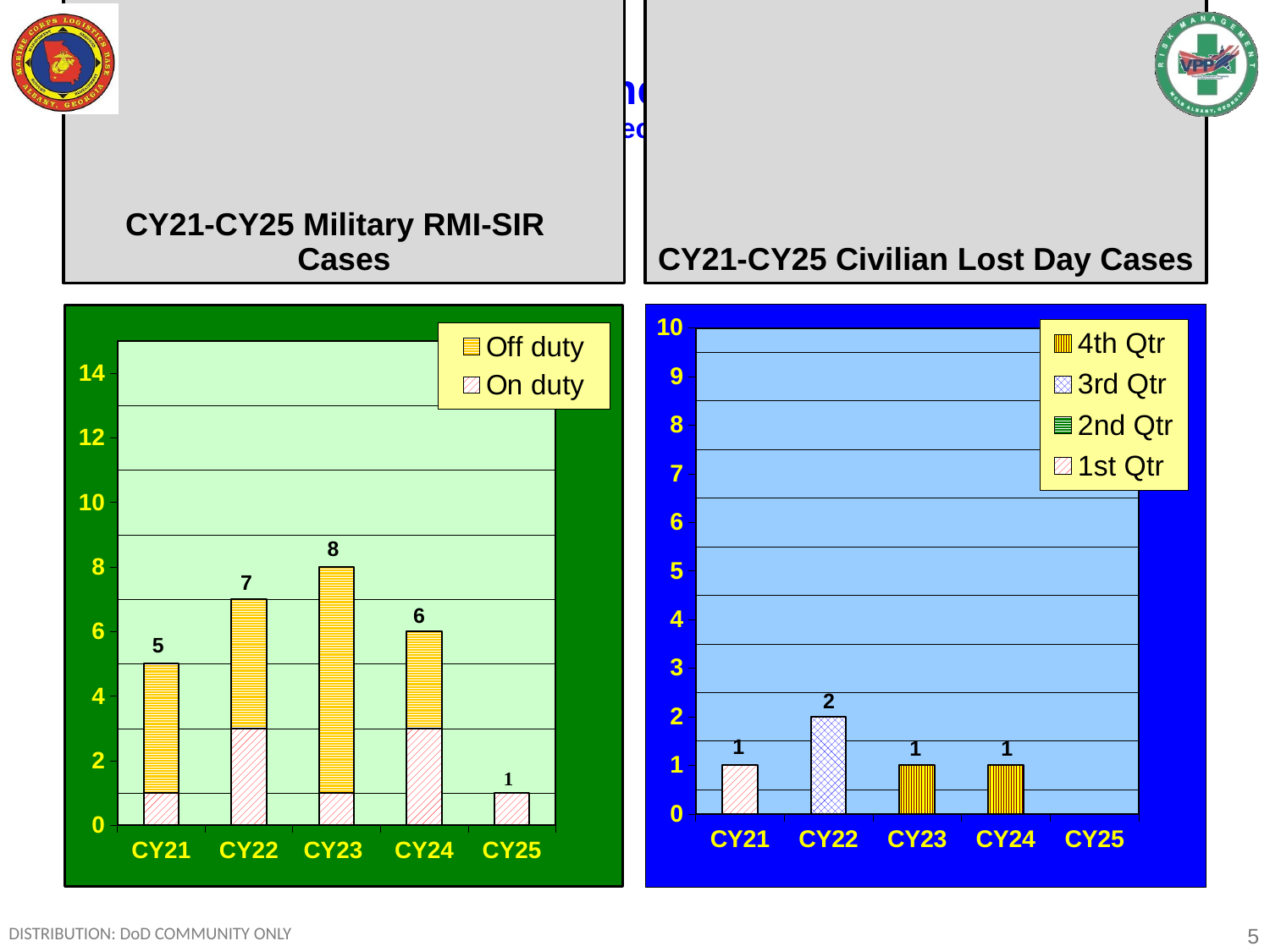
In the CY21-CY25 Civilian Lost Day Cases chart, which year has the highest value? CY22 In the CY21-CY25 Military RMI-SIR Cases chart, how many series does the legend list? 2 In the CY21-CY25 Civilian Lost Day Cases chart, how many year categories are shown on the x axis? 5 What kind of chart is the CY21-CY25 Civilian Lost Day Cases chart? Bar chart In the CY21-CY25 Military RMI-SIR Cases chart, which year has the lowest total? CY25 In the CY21-CY25 Military RMI-SIR Cases chart, what is the difference between the CY22 total and the CY21 total? 2 In the CY21-CY25 Military RMI-SIR Cases chart, which is larger, the total for CY24 or the total for CY21? CY24 In the CY21-CY25 Civilian Lost Day Cases chart, how many series does the legend list? 4 In the CY21-CY25 Civilian Lost Day Cases chart, what is the value for CY22? 2 In the CY21-CY25 Military RMI-SIR Cases chart, which year has the highest total? CY23 In the CY21-CY25 Military RMI-SIR Cases chart, what is the total number of cases for CY23? 8 In the CY21-CY25 Military RMI-SIR Cases chart, is the On duty value for CY22 greater or less than 2? greater